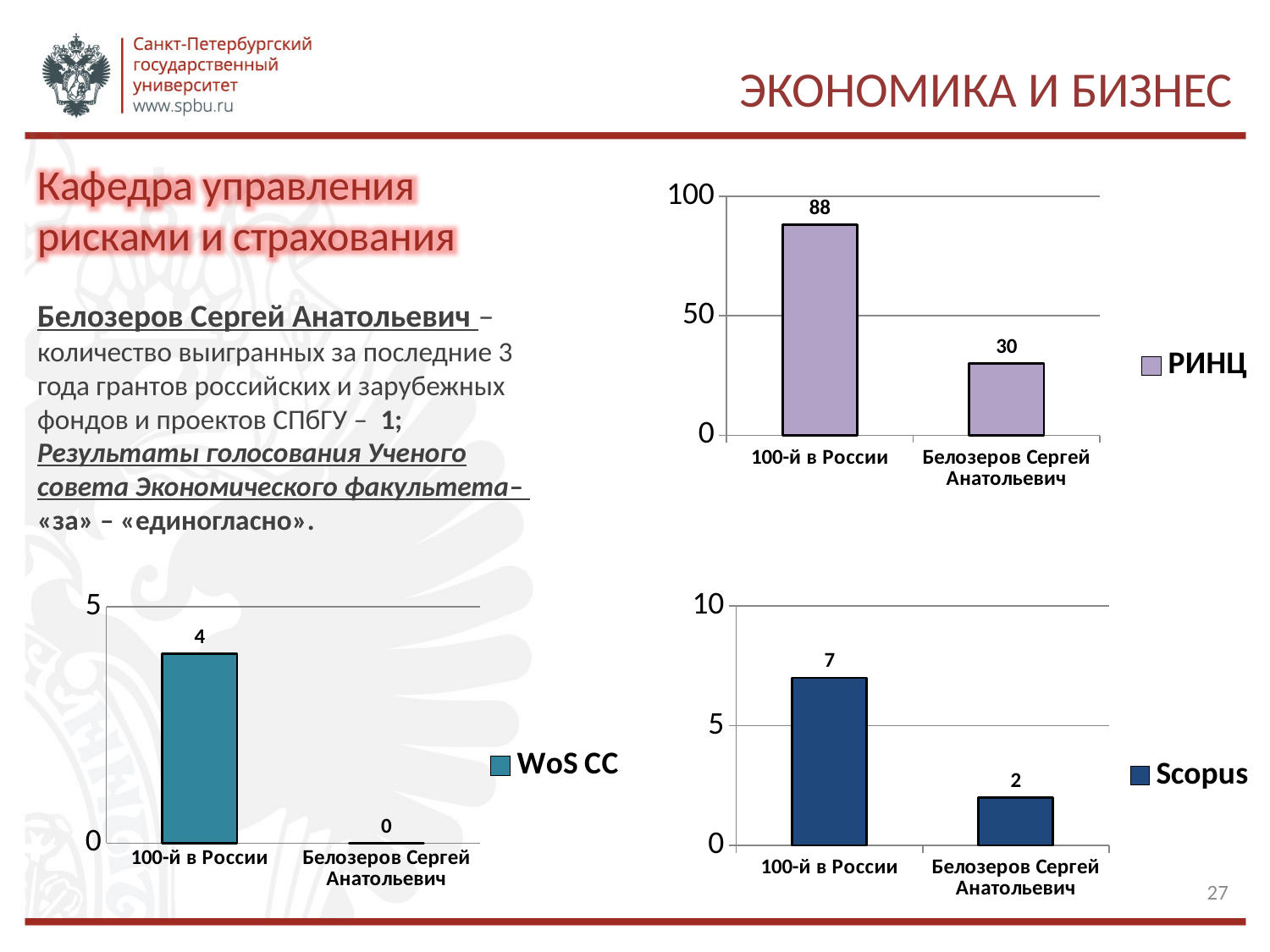
In the РИНЦ chart (top right), what is the value for 100-й в России? 88 In the Scopus chart (bottom right), what is the difference between the values for 100-й в России and Белозеров Сергей Анатольевич? 5 In the WoS CC chart (bottom left), what is the value for Белозеров Сергей Анатольевич? 0 In the Scopus chart (bottom right), what is the value for Белозеров Сергей Анатольевич? 2 How many categories are shown in the WoS CC chart (bottom left)? 2 In the РИНЦ chart (top right), is the value for 100-й в России greater or less than 50? greater In the Scopus chart (bottom right), what is the value for 100-й в России? 7 What kind of chart is the Scopus chart (bottom right)? bar chart In the РИНЦ chart (top right), what is the value for Белозеров Сергей Анатольевич? 30 In the WoS CC chart (bottom left), what is the value for 100-й в России? 4 In the Scopus chart (bottom right), which category has the higher value? 100-й в России In the РИНЦ chart (top right), what is the difference between the values for 100-й в России and Белозеров Сергей Анатольевич? 58